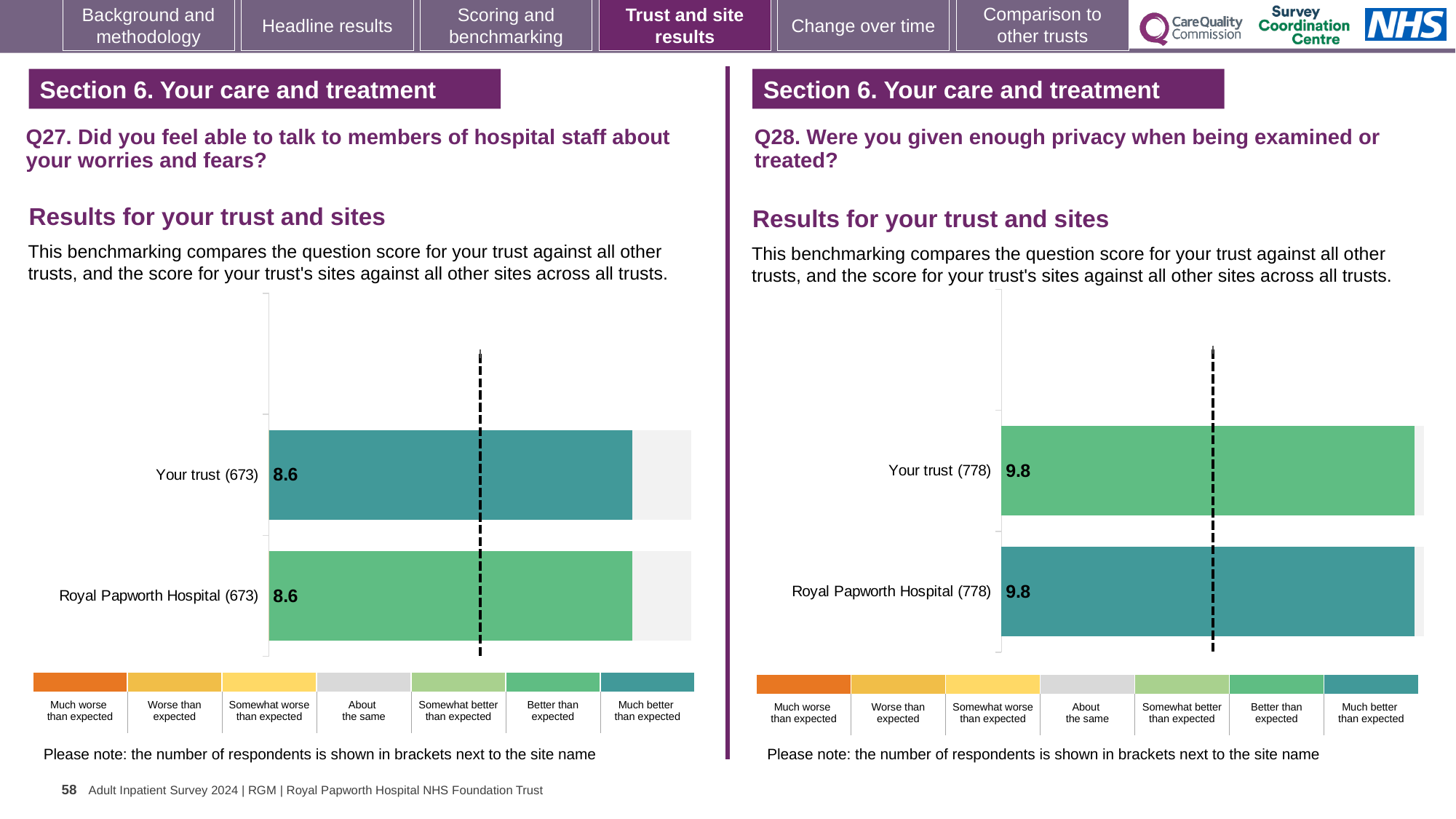
In the Q28 chart on the right, what is the score for Your trust? 9.8 In the Q27 chart on the left, how many respondents are shown in brackets next to Your trust? 673 In the Q27 chart on the left, what is the difference between the score for Your trust and the score for Royal Papworth Hospital? 0 In the Q27 chart on the left, what is the score for Royal Papworth Hospital? 8.6 In the Q28 chart on the right, how many respondents are shown in brackets next to Royal Papworth Hospital? 778 What kind of chart is used for the Q27 results on the left? Bar chart How many bars are plotted in the Q27 chart on the left? 2 How many bars are plotted in the Q28 chart on the right? 2 In the Q28 chart on the right, what is the score for Royal Papworth Hospital? 9.8 In the Q27 chart on the left, what is the score for Your trust? 8.6 Is the score for Your trust in the Q28 chart on the right larger or smaller than the score for Your trust in the Q27 chart on the left? Larger In the Q28 chart on the right, what is the difference between the score for Your trust and the score for Royal Papworth Hospital? 0